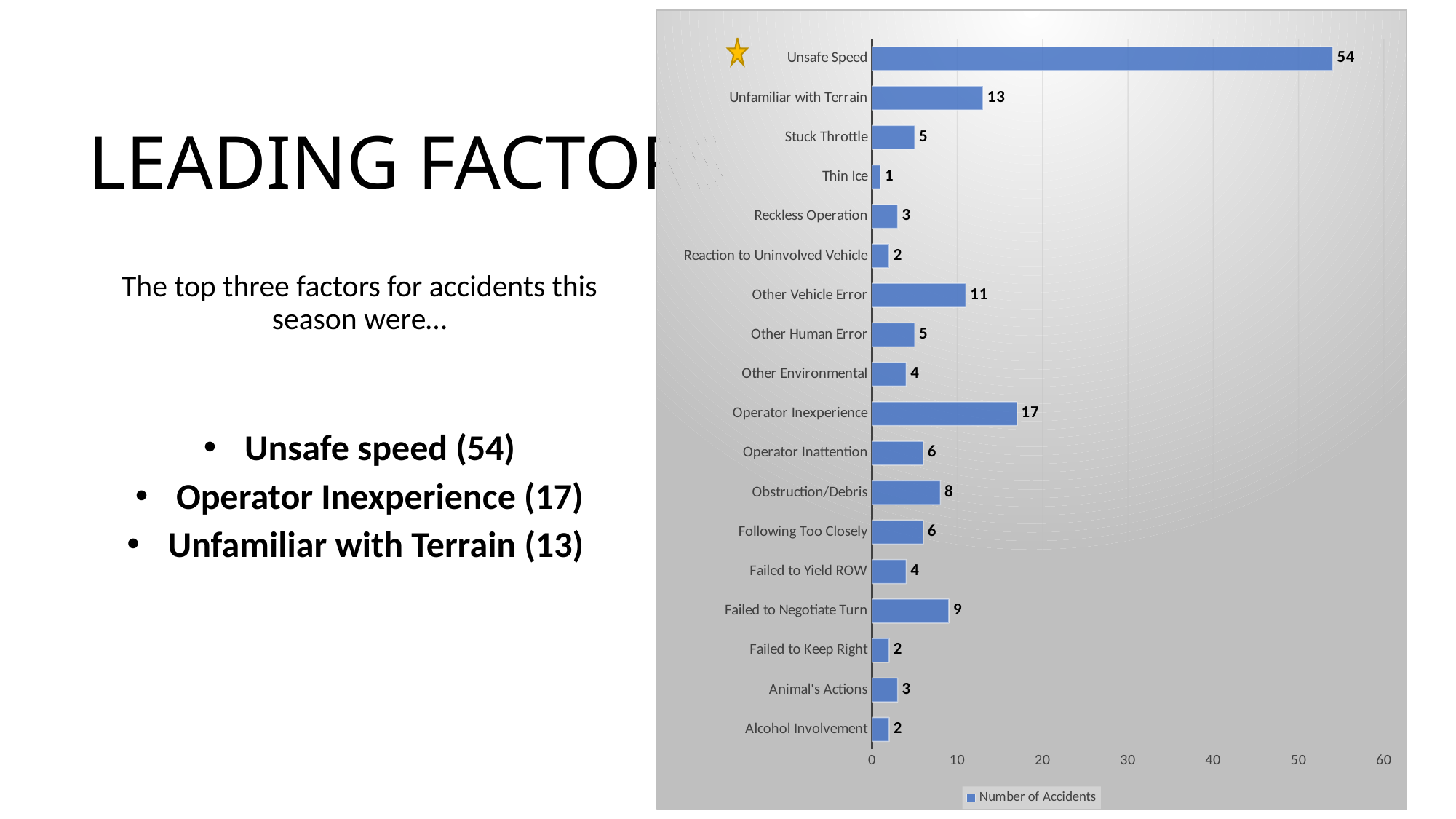
Which category has the lowest value? Thin Ice What kind of chart is shown? bar chart What series name does the legend show? Number of Accidents Which is larger, Other Vehicle Error or Unfamiliar with Terrain? Unfamiliar with Terrain How many categories are shown in the chart? 18 What is the difference between Unsafe Speed and Operator Inexperience? 37 Which category has the highest value? Unsafe Speed What is the value for Operator Inexperience? 17 What is the value for Obstruction/Debris? 8 What is the value for Failed to Negotiate Turn? 9 Is the value for Unsafe Speed greater or less than 50? greater What is the value for Unsafe Speed? 54